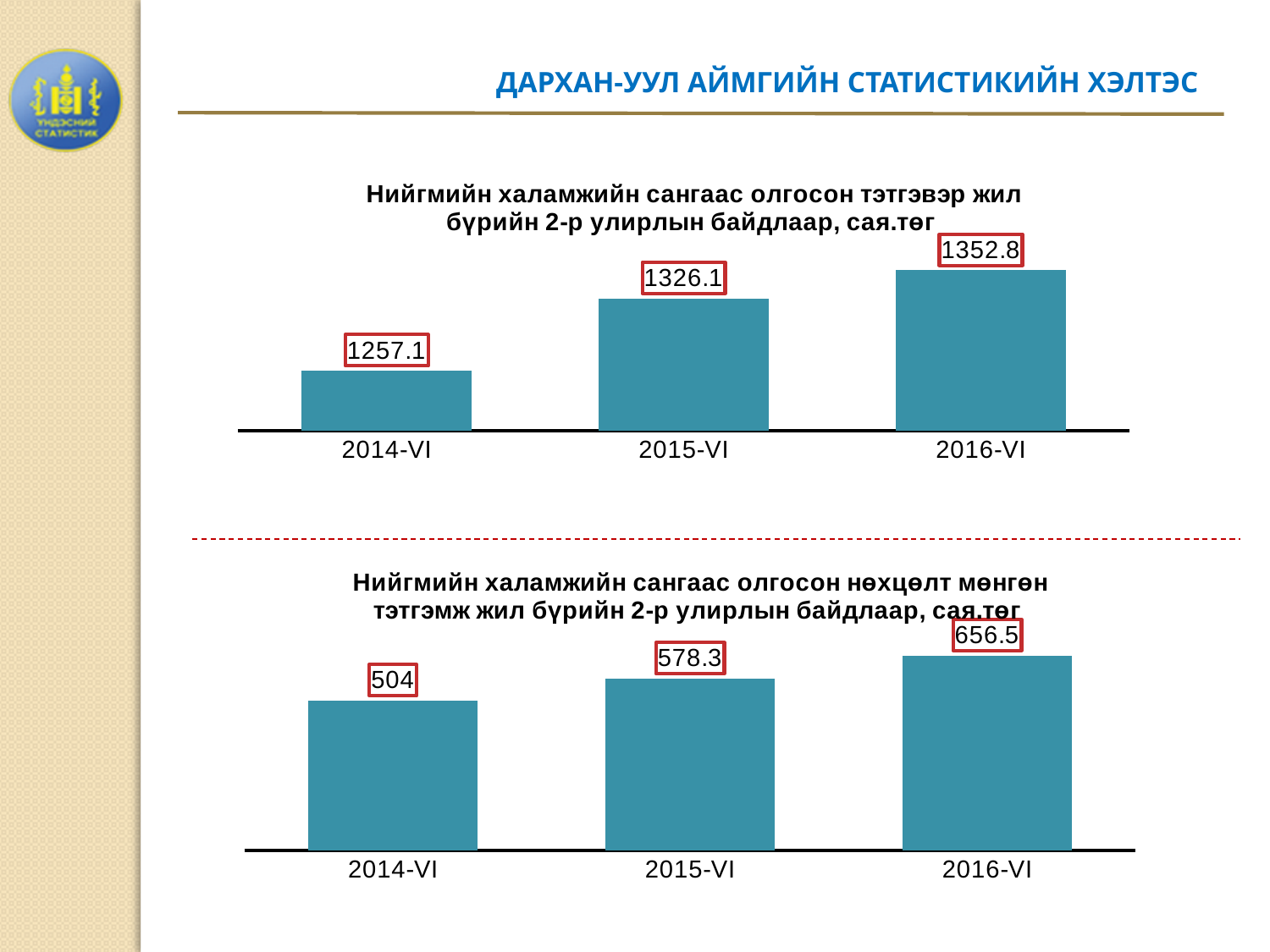
In the bottom chart (Нийгмийн халамжийн сангаас олгосон нөхцөлт мөнгөн тэтгэмж), what is the value for 2014-VI? 504 In the top chart (Нийгмийн халамжийн сангаас олгосон тэтгэвэр), what is the value for 2015-VI? 1326.1 In the bottom chart (Нийгмийн халамжийн сангаас олгосон нөхцөлт мөнгөн тэтгэмж), what is the difference between the 2016-VI and 2015-VI values? 78.2 In the bottom chart (Нийгмийн халамжийн сангаас олгосон нөхцөлт мөнгөн тэтгэмж), which period has the lowest value? 2014-VI What kind of chart is the bottom chart (Нийгмийн халамжийн сангаас олгосон нөхцөлт мөнгөн тэтгэмж)? bar chart In the top chart (Нийгмийн халамжийн сангаас олгосон тэтгэвэр), what is the value for 2014-VI? 1257.1 In the bottom chart (Нийгмийн халамжийн сангаас олгосон нөхцөлт мөнгөн тэтгэмж), which is larger, the value for 2015-VI or 2014-VI? 2015-VI In the top chart (Нийгмийн халамжийн сангаас олгосон тэтгэвэр), what is the difference between the 2016-VI and 2014-VI values? 95.7 In the bottom chart (Нийгмийн халамжийн сангаас олгосон нөхцөлт мөнгөн тэтгэмж), what is the value for 2016-VI? 656.5 In the top chart (Нийгмийн халамжийн сангаас олгосон тэтгэвэр), do the values rise or fall from 2014-VI to 2016-VI? rise In the top chart (Нийгмийн халамжийн сангаас олгосон тэтгэвэр), which period has the highest value? 2016-VI How many periods are shown on the x axis of the top chart (Нийгмийн халамжийн сангаас олгосон тэтгэвэр)? 3